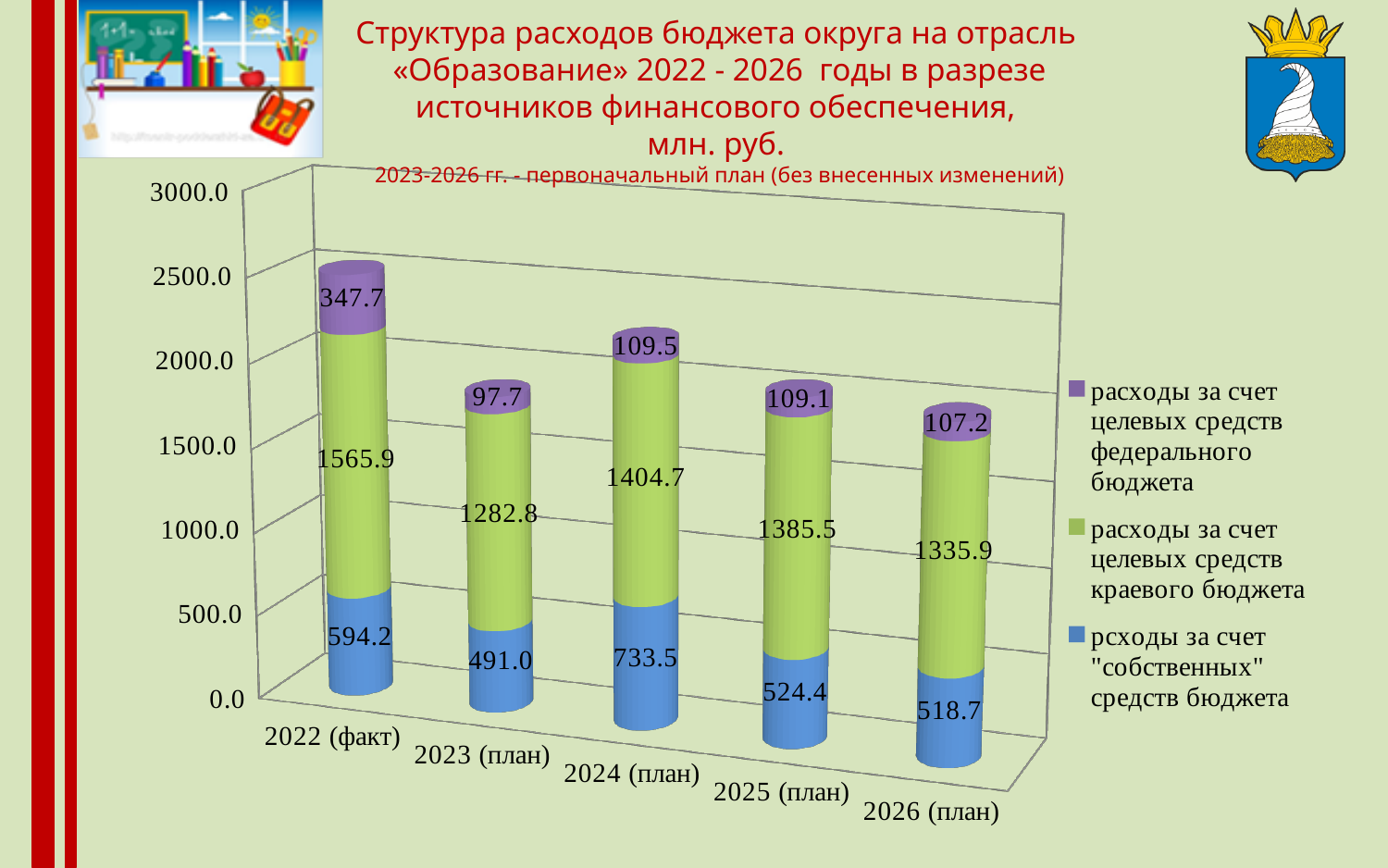
Which year has the highest value for расходы за счет целевых средств федерального бюджета? 2022 (факт) Which is larger: the "собственных" средств value for 2025 (план) or for 2026 (план)? 2025 (план) What is the total of the stacked bar for 2022 (факт)? 2507.8 Which year has the lowest value for рсходы за счет "собственных" средств бюджета? 2023 (план) How many series does the legend list? 3 What is the value of рсходы за счет "собственных" средств бюджета for 2024 (план)? 733.5 What kind of chart is shown on the slide? Stacked bar chart What is the total of the stacked bar for 2023 (план)? 1871.5 What is the difference between the краевого бюджета values for 2024 (план) and 2023 (план)? 121.9 What is the value of расходы за счет целевых средств федерального бюджета for 2026 (план)? 107.2 How many years (categories) are shown on the x axis? 5 What is the value of расходы за счет целевых средств краевого бюджета for 2022 (факт)? 1565.9